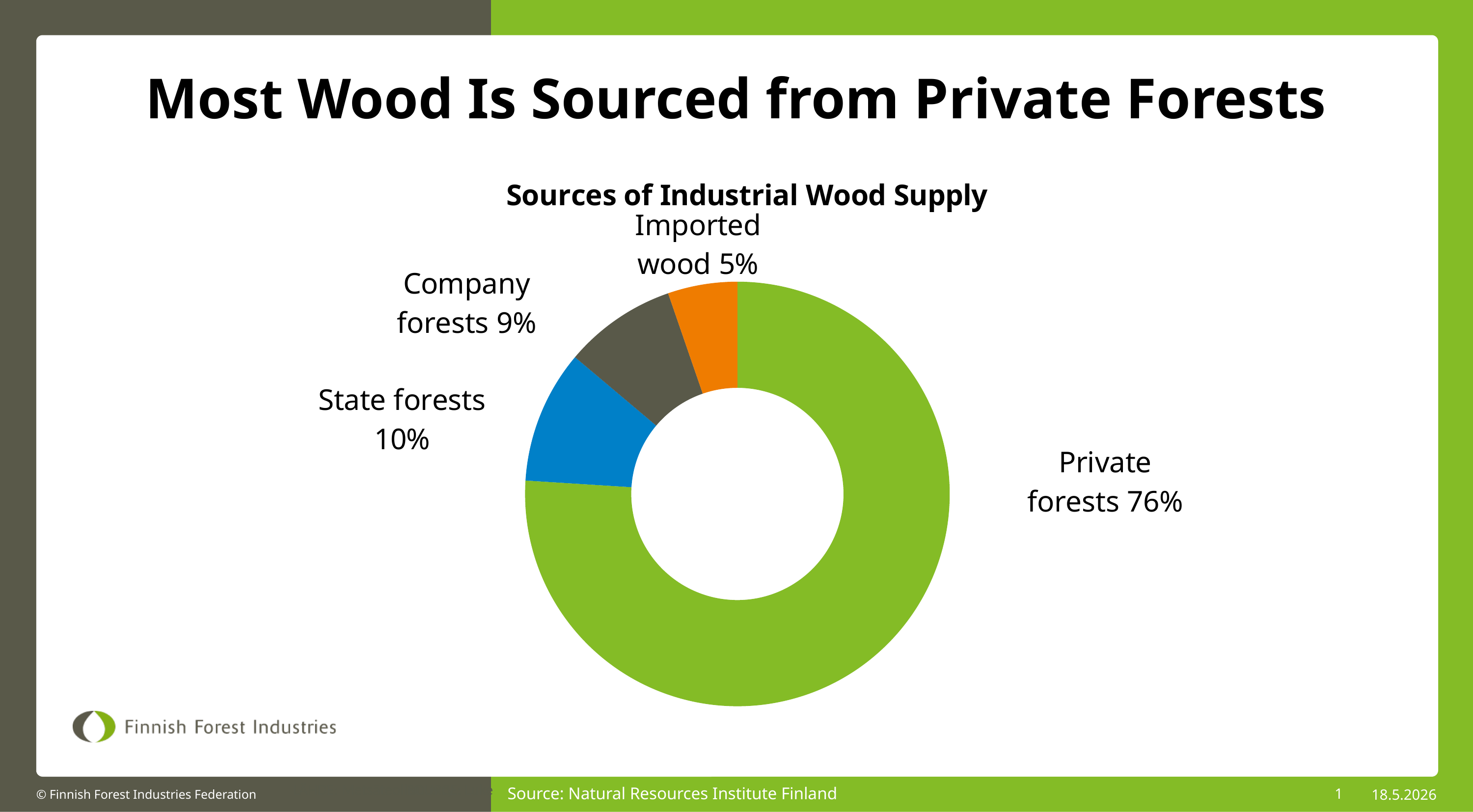
What share of industrial wood supply comes from company forests? 9% How many percentage points larger is the private forests share than the state forests share? 66 Which source accounts for the largest share of industrial wood supply? Private forests Which source accounts for the smallest share of industrial wood supply? Imported wood What share of industrial wood supply is imported wood? 5% How many sources of industrial wood supply are shown in the chart? 4 What is the difference in percentage points between the company forests share and the imported wood share? 4 What share of industrial wood supply comes from private forests? 76% Which is larger, the share from state forests or the share from company forests? State forests What share of industrial wood supply comes from state forests? 10% What kind of chart is used to show the sources of industrial wood supply? Pie chart (doughnut) What is the title of the chart? Sources of Industrial Wood Supply